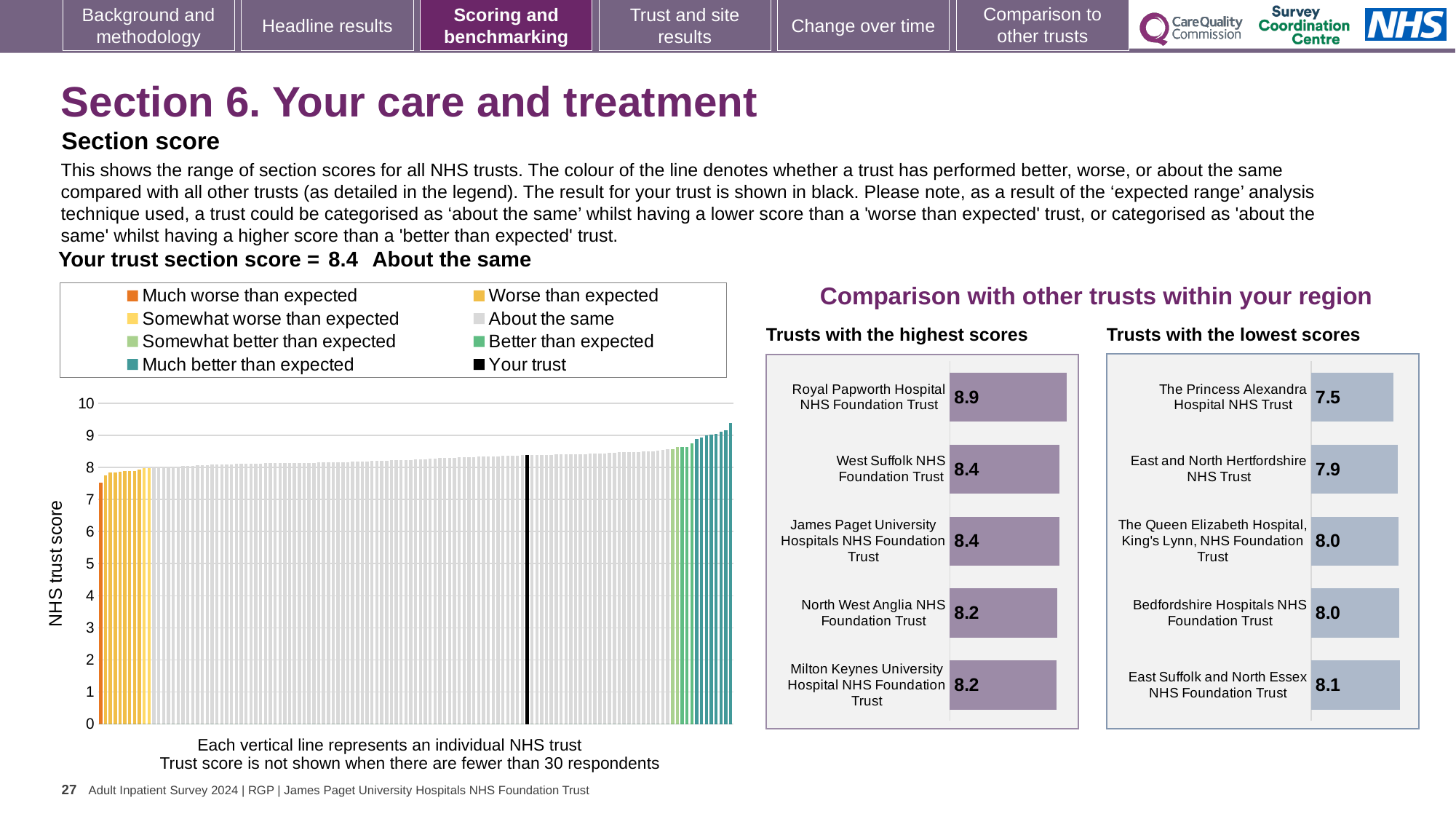
In the 'Trusts with the lowest scores' chart, what is the score for Bedfordshire Hospitals NHS Foundation Trust? 8.0 In the 'Trusts with the lowest scores' chart, which trust has the lowest score? The Princess Alexandra Hospital NHS Trust In the main chart of all NHS trusts on the left, what is the section score for your trust? 8.4 In the 'Trusts with the lowest scores' chart, what is the difference between the scores of East Suffolk and North Essex NHS Foundation Trust and The Princess Alexandra Hospital NHS Trust? 0.6 In the main chart on the left, do the trust scores rise or fall from left to right? Rise In the 'Trusts with the highest scores' chart, what is the score for Royal Papworth Hospital NHS Foundation Trust? 8.9 What kind of chart is the main chart on the left showing NHS trust scores? Bar chart In the 'Trusts with the highest scores' chart, what is the difference between the scores of Royal Papworth Hospital NHS Foundation Trust and North West Anglia NHS Foundation Trust? 0.7 How many entries does the legend of the main chart on the left list? 8 In the 'Trusts with the highest scores' chart, which trust has the highest score? Royal Papworth Hospital NHS Foundation Trust How many trusts are shown in the 'Trusts with the lowest scores' chart? 5 In the 'Trusts with the highest scores' chart, which has the larger score: West Suffolk NHS Foundation Trust or North West Anglia NHS Foundation Trust? West Suffolk NHS Foundation Trust